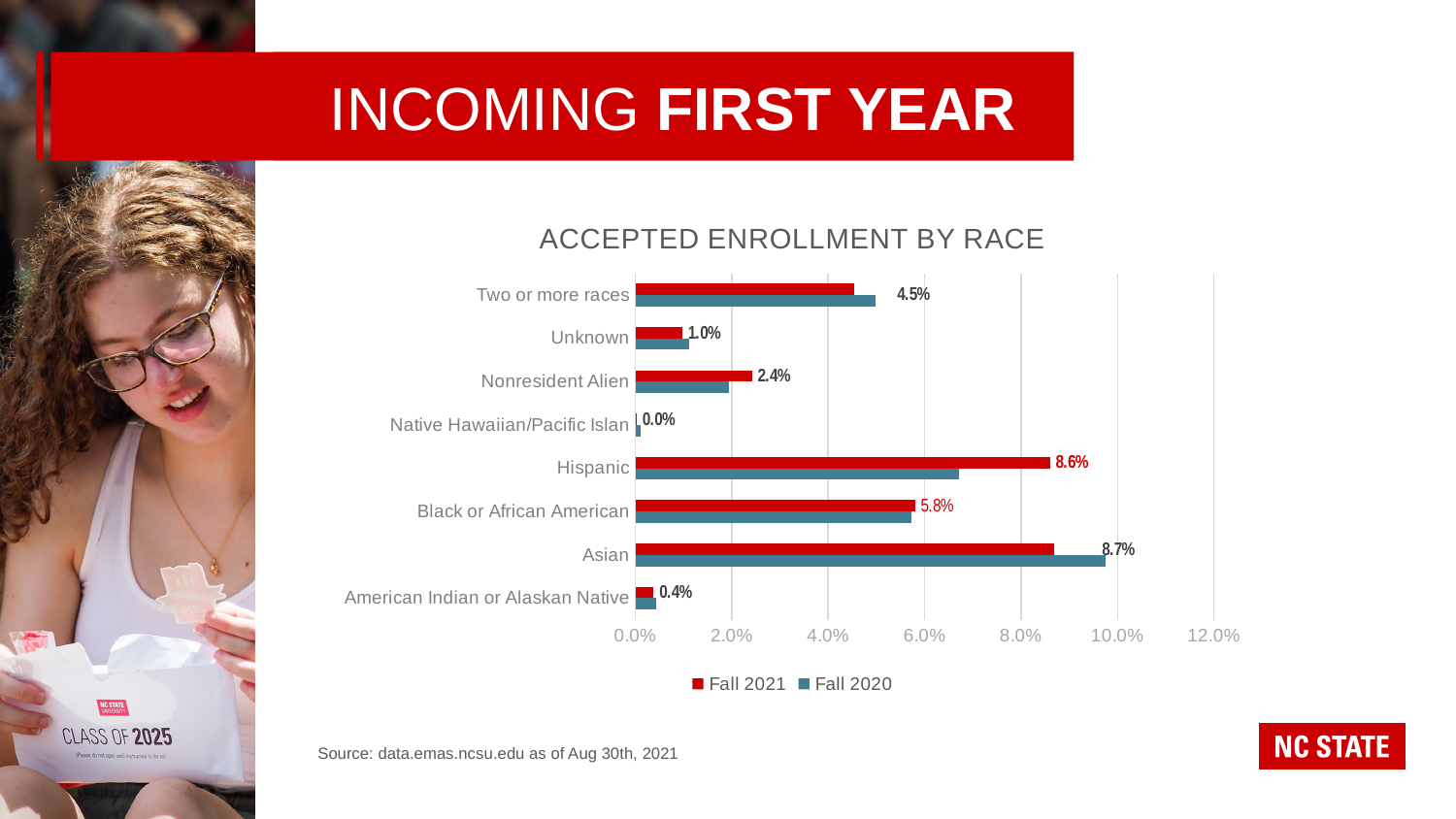
What is the Fall 2021 value for Nonresident Alien? 2.4% How many categories are shown on the chart? 8 What is the Fall 2021 value for Two or more races? 4.5% What is the difference between the Fall 2021 values for Hispanic and Black or African American? 2.8% Which category has the highest Fall 2021 value? Asian For Hispanic, which series has the larger value, Fall 2021 or Fall 2020? Fall 2021 What is the Fall 2021 value for Hispanic? 8.6% Which category has the lowest Fall 2021 value? Native Hawaiian/Pacific Islan Is the Fall 2020 value for Asian greater or less than 8.0%? greater What kind of chart is shown on the slide? bar chart How many series does the legend list? 2 For Asian, which series has the larger value, Fall 2021 or Fall 2020? Fall 2020